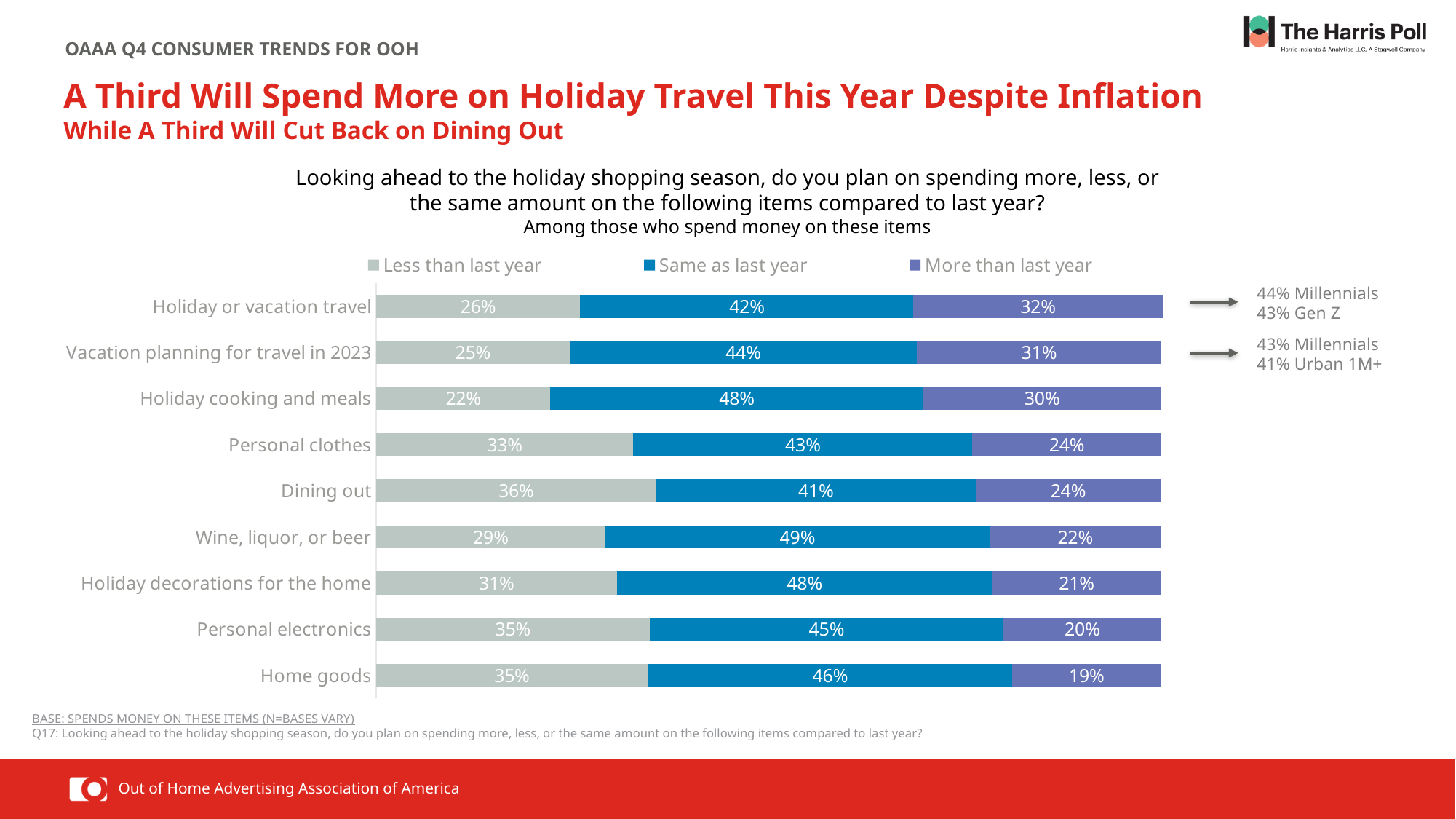
What percentage plan to spend less than last year on dining out? 36% How many series does the legend list? 3 Which is larger: the 'More than last year' share for personal clothes or for holiday decorations for the home? Personal clothes What percentage of respondents plan to spend more than last year on holiday or vacation travel? 32% How many items are listed in the chart? 9 What is the total of the three segments for the 'Personal electronics' bar? 100% What kind of chart is shown on the slide? Stacked bar chart Which item has the lowest share of respondents planning to spend more than last year? Home goods Which item has the highest share of respondents planning to spend more than last year? Holiday or vacation travel What is the difference between the 'Less than last year' percentages for dining out and holiday or vacation travel? 10% What percentage plan to spend the same as last year on wine, liquor, or beer? 49% Which item has the lowest share of respondents planning to spend less than last year? Holiday cooking and meals